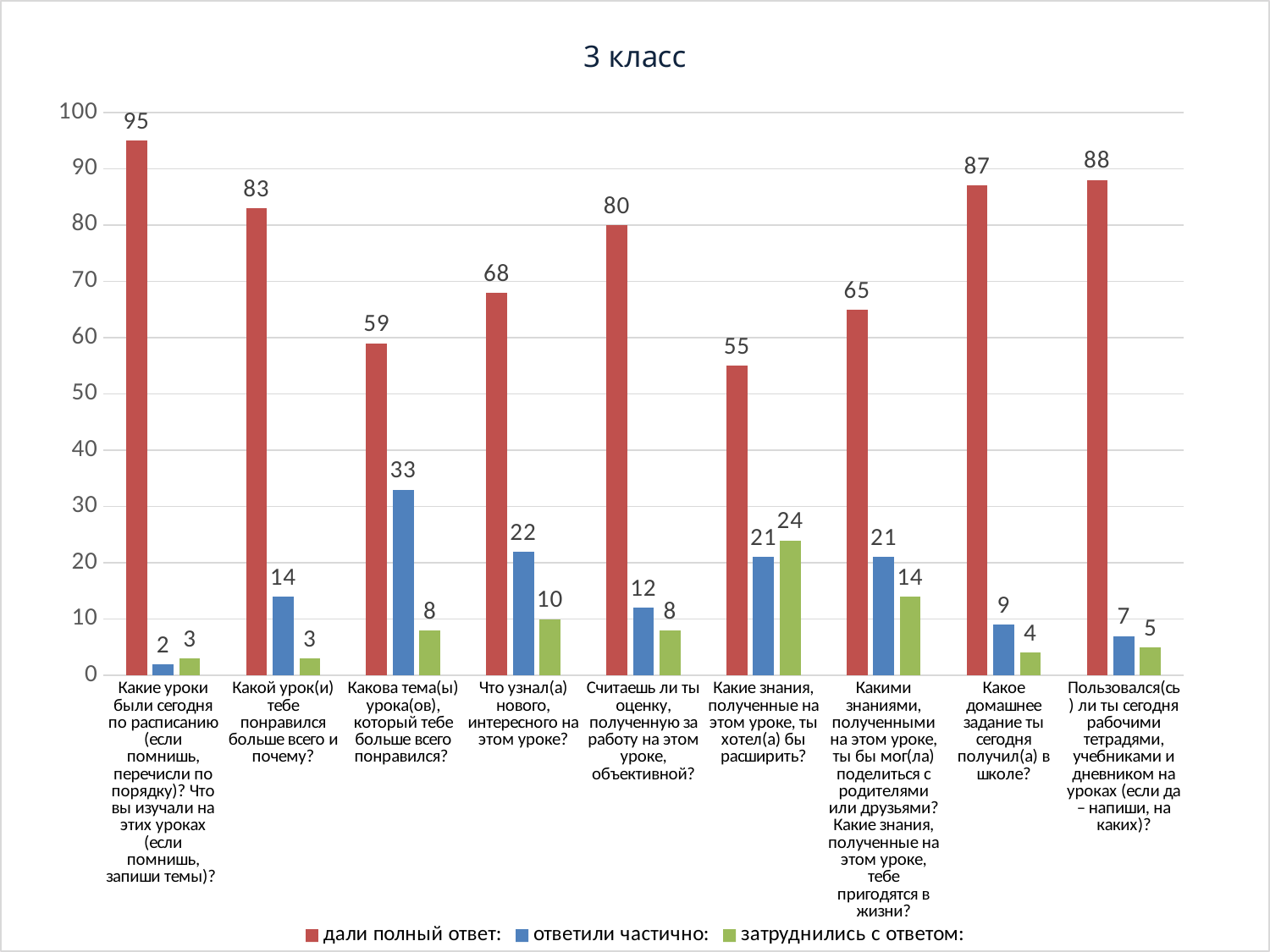
What is the value of "дали полный ответ:" for the question "Какое домашнее задание ты сегодня получил(а) в школе?"? 87 What is the difference between the "дали полный ответ:" values for "Какой урок(и) тебе понравился больше всего и почему?" and "Что узнал(а) нового, интересного на этом уроке?"? 15 How many question categories are shown on the x axis? 9 What is the value of "затруднились с ответом:" for the question "Какие знания, полученные на этом уроке, ты хотел(а) бы расширить?"? 24 Which is larger for the question "Какие знания, полученные на этом уроке, ты хотел(а) бы расширить?": "ответили частично:" or "затруднились с ответом:"? затруднились с ответом: For which question is the "дали полный ответ:" value the lowest? Какие знания, полученные на этом уроке, ты хотел(а) бы расширить? How many series does the legend list? 3 What is the value of "ответили частично:" for the question "Какова тема(ы) урока(ов), который тебе больше всего понравился?"? 33 What type of chart is shown on the slide? bar chart What is the total of the three values for the question "Считаешь ли ты оценку, полученную за работу на этом уроке, объективной?"? 100 What is the title of the chart? 3 класс For which question is the "дали полный ответ:" value the highest? Какие уроки были сегодня по расписанию (если помнишь, перечисли по порядку)? Что вы изучали на этих уроках (если помнишь, запиши темы)?